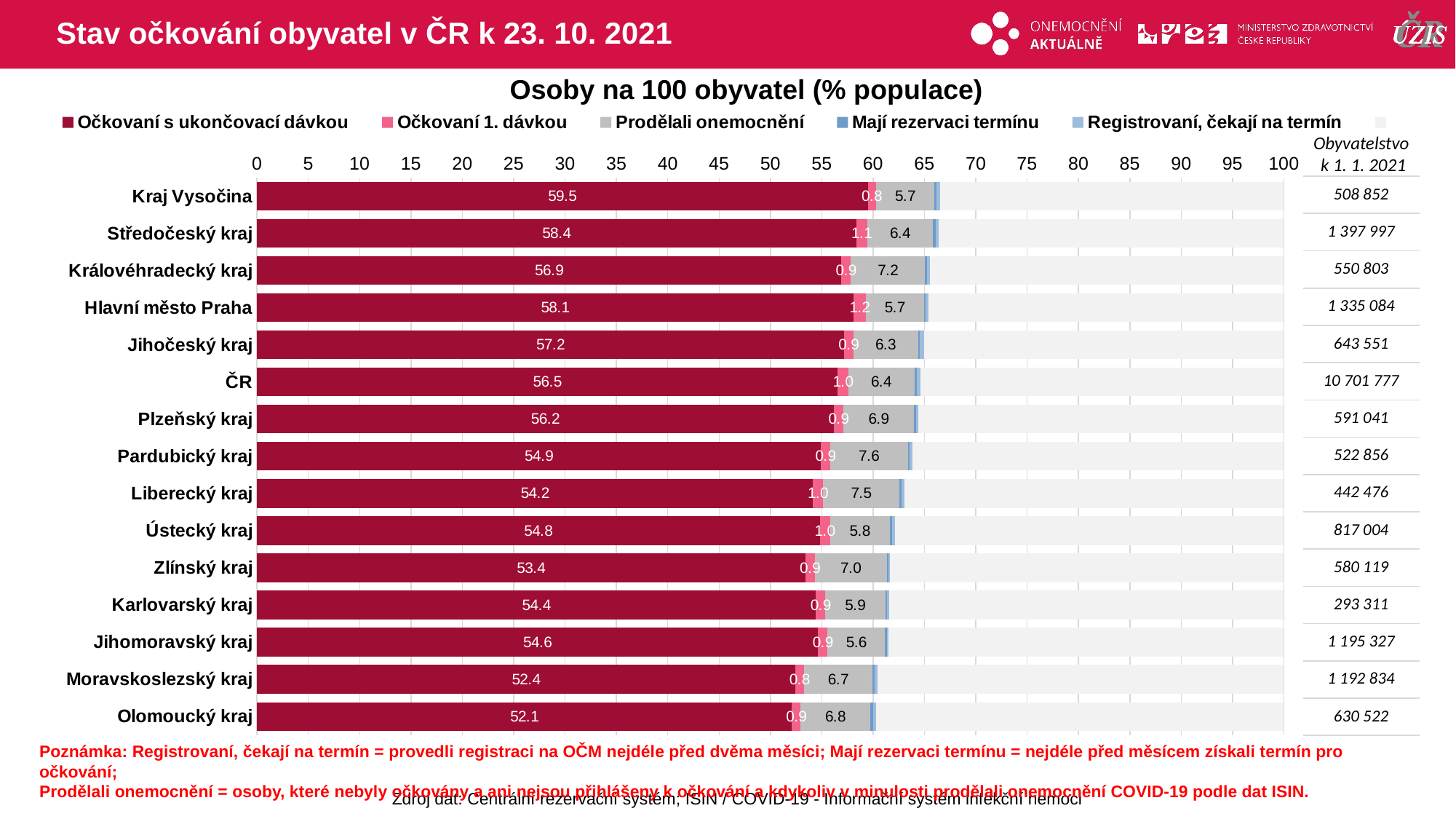
Which has a larger value for 'Očkovaní s ukončovací dávkou', Jihočeský kraj or Plzeňský kraj? Jihočeský kraj What is the difference in 'Očkovaní s ukončovací dávkou' between Kraj Vysočina and Olomoucký kraj? 7.4 What kind of chart is shown on the slide? Bar chart Which region has the lowest value for 'Očkovaní s ukončovací dávkou'? Olomoucký kraj What is the title of the chart? Osoby na 100 obyvatel (% populace) Is the total length of the stacked bar for Olomoucký kraj greater or less than 65? less Do the values for 'Očkovaní s ukončovací dávkou' generally rise or fall going from the top region to the bottom region? fall How many regions (categories) are plotted in the chart? 15 What is the value of 'Očkovaní 1. dávkou' for Hlavní město Praha? 1.2 Which region has the highest value for 'Očkovaní s ukončovací dávkou'? Kraj Vysočina What is the value of 'Očkovaní s ukončovací dávkou' for Kraj Vysočina? 59.5 What is the value of 'Prodělali onemocnění' for Pardubický kraj? 7.6